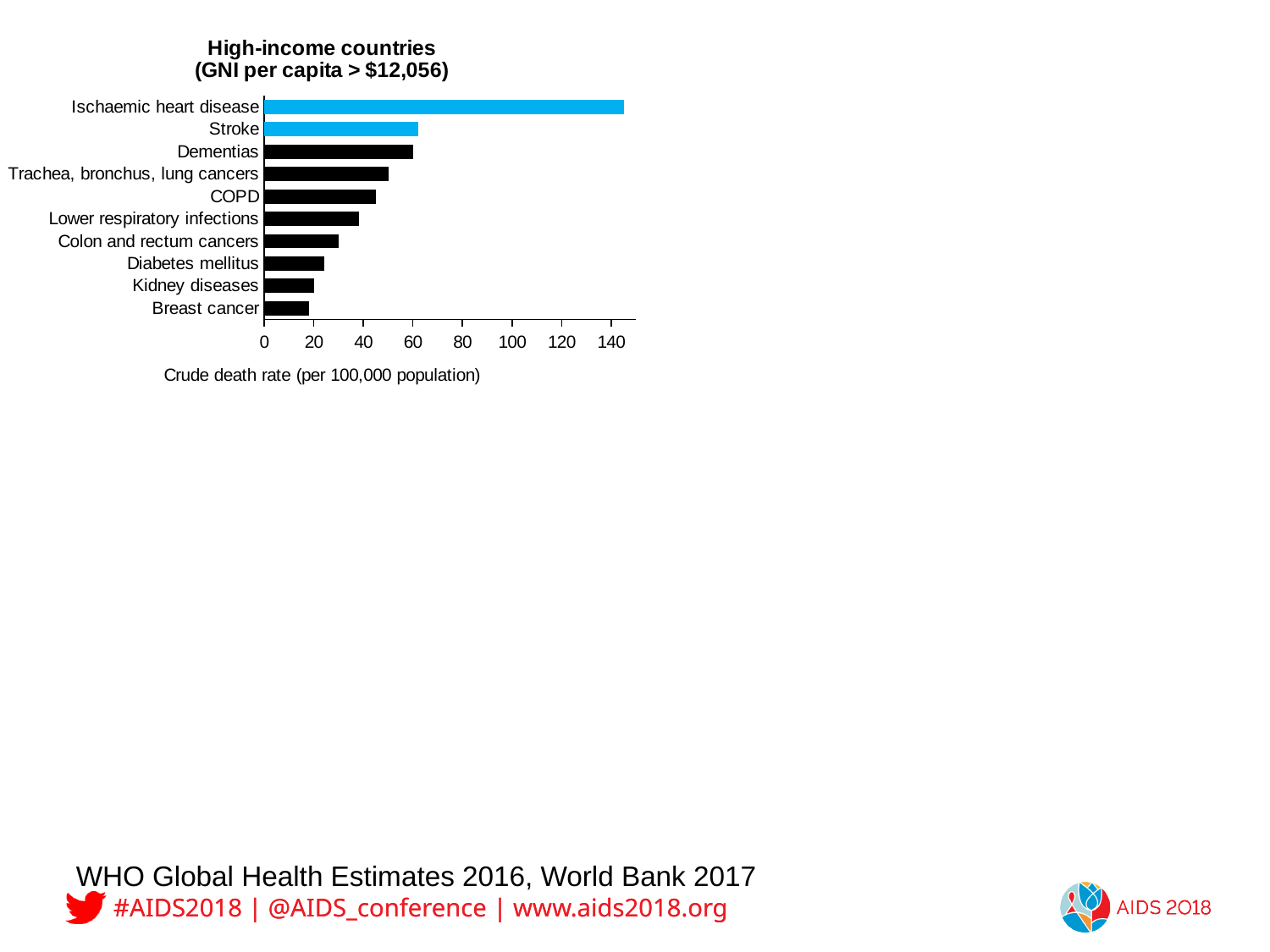
What is the label on the horizontal axis of the chart? Crude death rate (per 100,000 population) What kind of chart is shown on the slide? Bar chart How many causes of death are listed on the chart? 10 Which cause of death has the lowest crude death rate? Breast cancer Is the crude death rate for Colon and rectum cancers greater or less than 20? greater Which cause of death has the highest crude death rate? Ischaemic heart disease What is the title of the chart? High-income countries (GNI per capita > $12,056) Is the crude death rate for Ischaemic heart disease greater or less than 120? greater Is the crude death rate for Stroke greater or less than 40? greater Which has a higher crude death rate, Ischaemic heart disease or Stroke? Ischaemic heart disease Which has a higher crude death rate, Dementias or Diabetes mellitus? Dementias